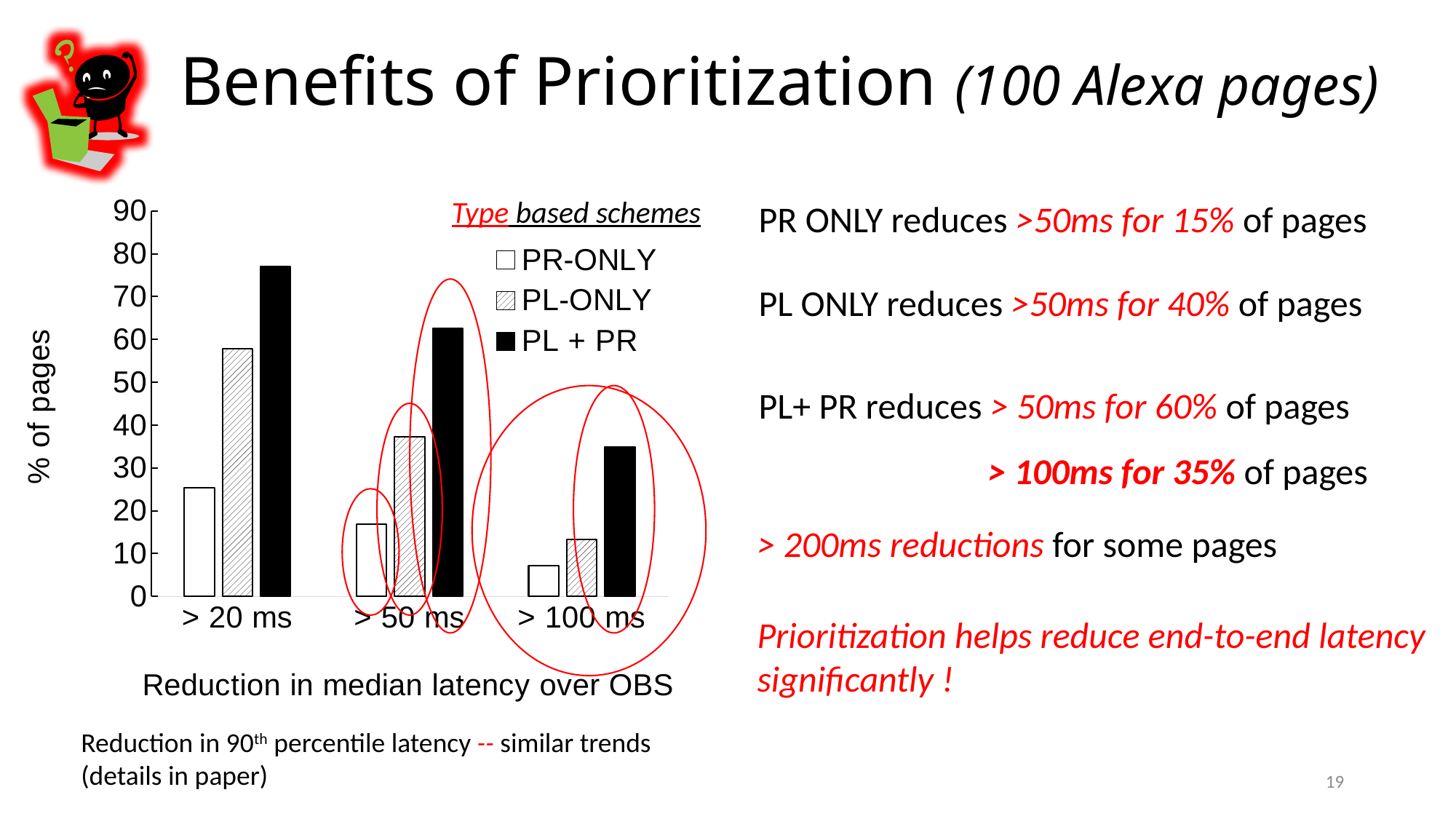
Is the value for PR-ONLY in the > 50 ms category greater or less than 20? less Which series has the highest value in the > 20 ms category? PL + PR How many categories are shown on the x axis of the chart? 3 Which is larger: PL-ONLY in the > 50 ms category or PR-ONLY in the > 50 ms category? PL-ONLY How many series does the chart legend list? 3 Is the value for PL + PR in the > 20 ms category greater or less than 70? greater Is the value for PL + PR in the > 100 ms category greater or less than 30? greater Which series has the lowest value in the > 100 ms category? PR-ONLY What kind of chart is shown on the slide? bar chart What is the label of the y axis of the chart? % of pages Do the PL + PR values rise or fall as you move from > 20 ms to > 100 ms along the x axis? fall